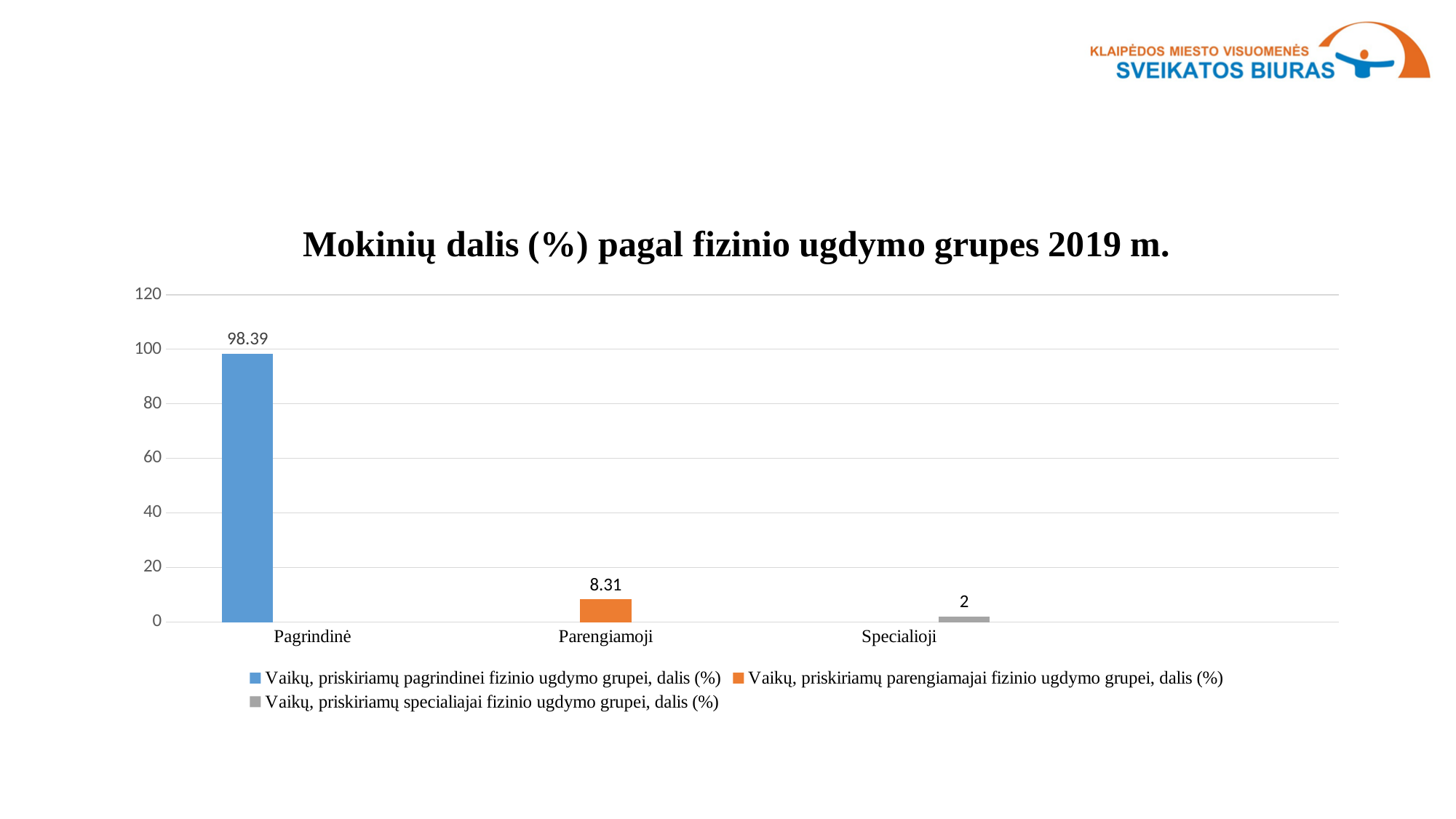
Which category has the highest value? Pagrindinė What kind of chart is shown on the slide? bar chart What is the difference between the values for Pagrindinė and Parengiamoji? 90.08 What is the difference between the values for Parengiamoji and Specialioji? 6.31 Which category has the lowest value? Specialioji What is the value for Pagrindinė? 98.39 What is the value for Parengiamoji? 8.31 How many series does the legend list? 3 Which is larger, the value for Parengiamoji or the value for Specialioji? Parengiamoji What is the value for Specialioji? 2 How many categories are shown on the x axis? 3 Is the value for Pagrindinė greater or less than 80? greater